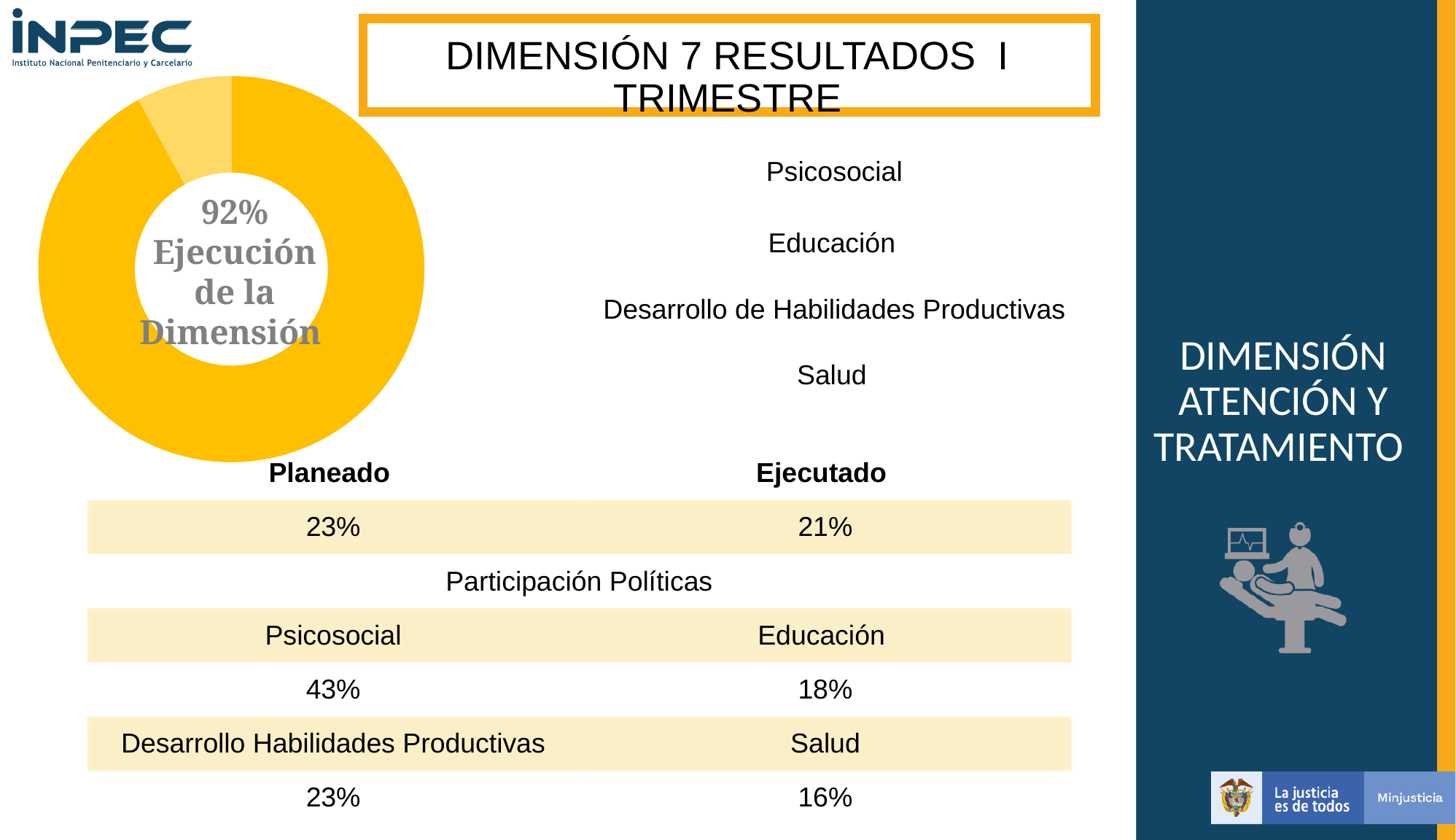
What percentage is printed in the centre of the doughnut chart? 92% What kind of chart is shown on the left of the slide? Doughnut chart What text appears in the centre of the doughnut chart? 92% Ejecución de la Dimensión Is the largest slice of the doughnut chart the dark yellow slice or one of the light yellow slices? The dark yellow slice According to the doughnut chart, what share of the dimension has been executed? 92% How many slices does the doughnut chart have? 3